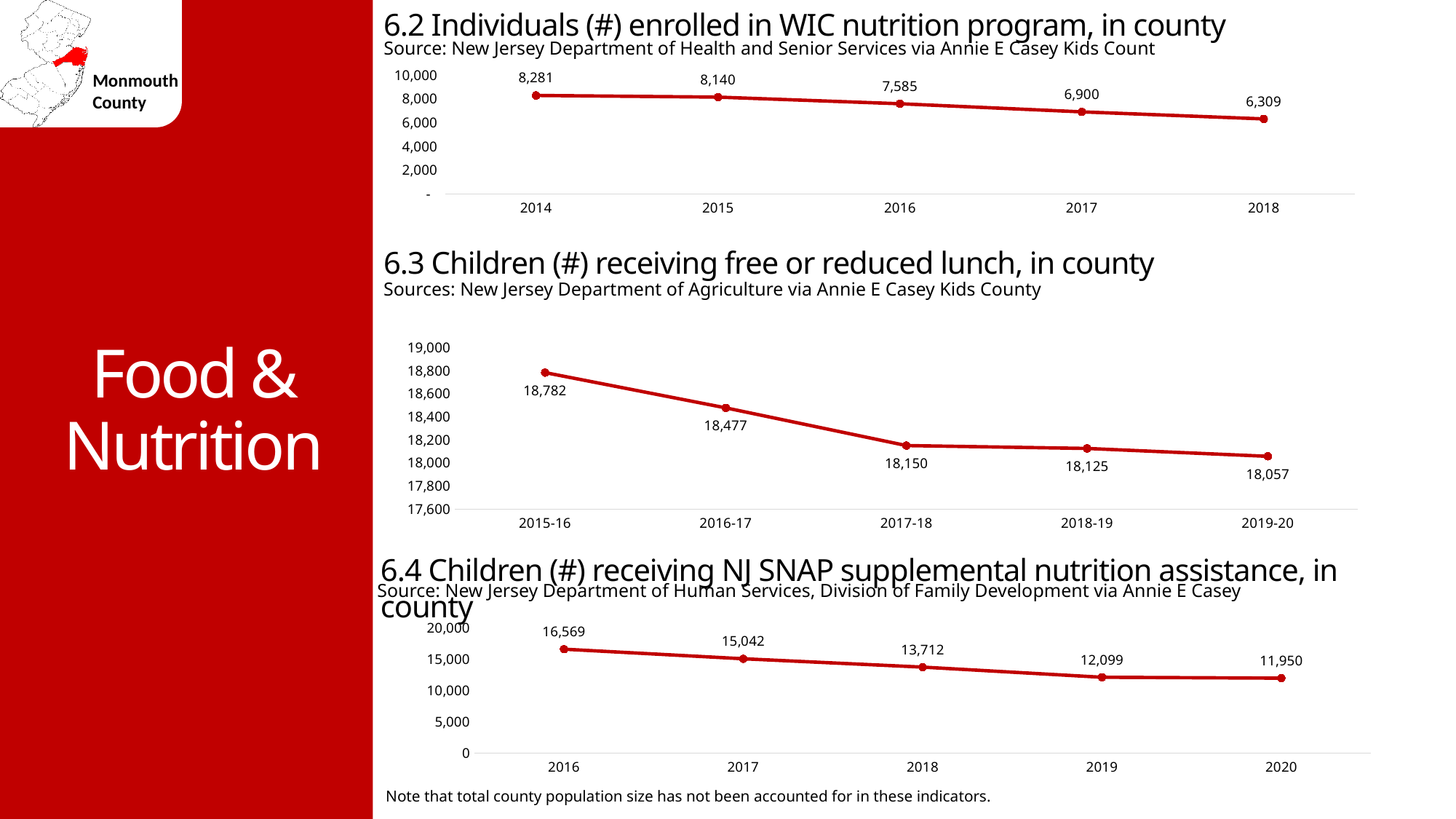
In the chart '6.4 Children (#) receiving NJ SNAP supplemental nutrition assistance, in county', which is larger, the value for 2017 or the value for 2019? 2017 In the chart '6.3 Children (#) receiving free or reduced lunch, in county', how many data points are plotted? 5 In the chart '6.3 Children (#) receiving free or reduced lunch, in county', which school year has the highest value? 2015-16 In the chart '6.3 Children (#) receiving free or reduced lunch, in county', what is the difference between the 2017-18 and 2018-19 values? 25 What type of chart is '6.4 Children (#) receiving NJ SNAP supplemental nutrition assistance, in county'? line chart In the chart '6.2 Individuals (#) enrolled in WIC nutrition program, in county', what is the difference between the 2014 and 2018 values? 1,972 In the chart '6.4 Children (#) receiving NJ SNAP supplemental nutrition assistance, in county', what is the difference between the 2016 and 2020 values? 4,619 In the chart '6.2 Individuals (#) enrolled in WIC nutrition program, in county', what is the value for 2016? 7,585 In the chart '6.3 Children (#) receiving free or reduced lunch, in county', what is the value for 2016-17? 18,477 In the chart '6.2 Individuals (#) enrolled in WIC nutrition program, in county', do the values rise or fall from 2014 to 2018? fall In the chart '6.2 Individuals (#) enrolled in WIC nutrition program, in county', which year has the lowest value? 2018 In the chart '6.4 Children (#) receiving NJ SNAP supplemental nutrition assistance, in county', what is the value for 2018? 13,712